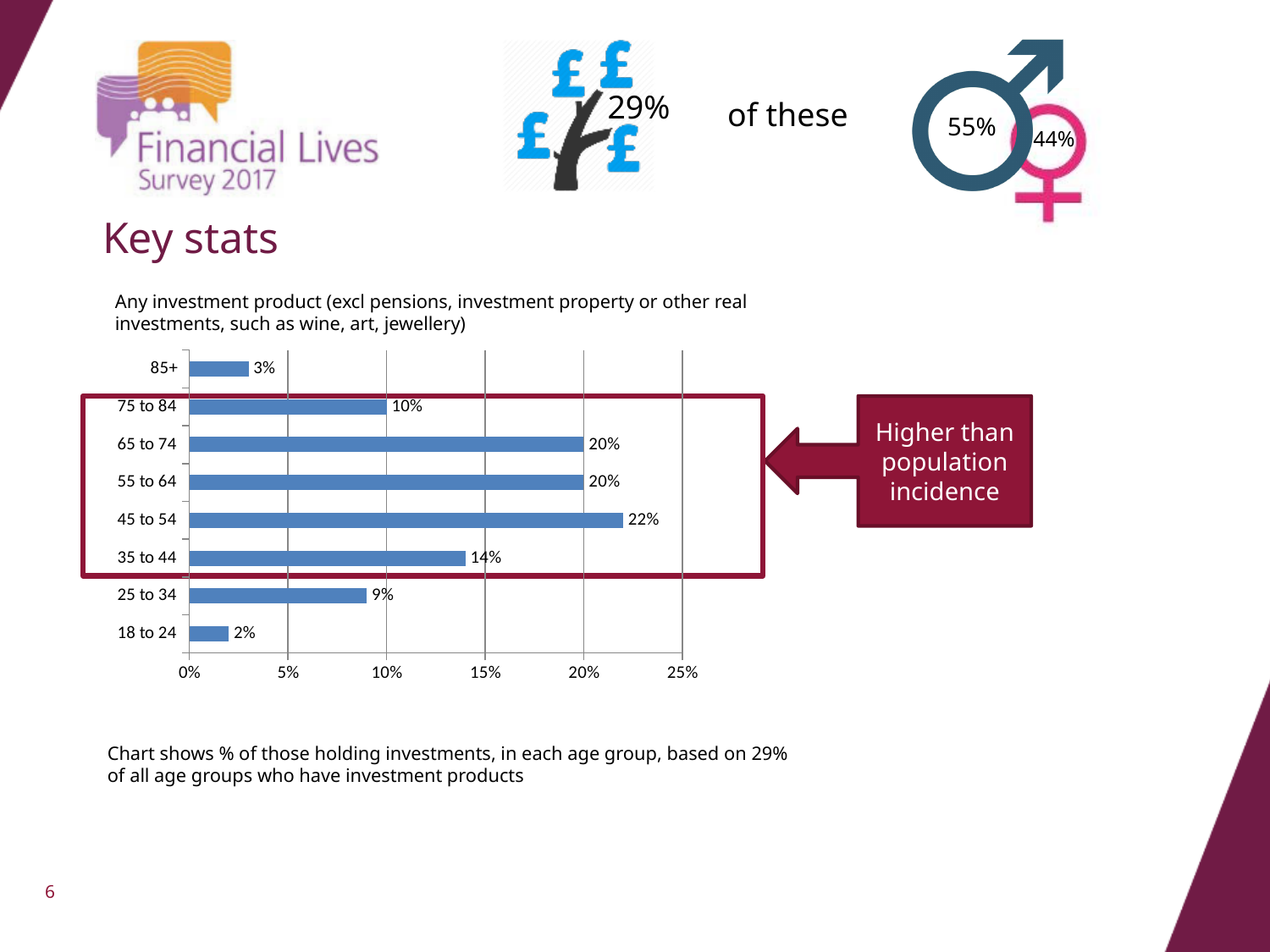
What kind of chart is shown on the slide? Bar chart What is the difference between the values for 45 to 54 and 35 to 44? 8% How many age groups are shown in the chart? 8 Which age group has the highest value? 45 to 54 What is the value for the 35 to 44 age group? 14% What does the text in the box to the right of the chart say? Higher than population incidence Which age group has the lowest value? 18 to 24 What is the difference between the values for 25 to 34 and 18 to 24? 7% What is the value for the 18 to 24 age group? 2% What is the value for the 75 to 84 age group? 10% What is the value for the 45 to 54 age group? 22% Which is larger, the value for 75 to 84 or the value for 25 to 34? 75 to 84